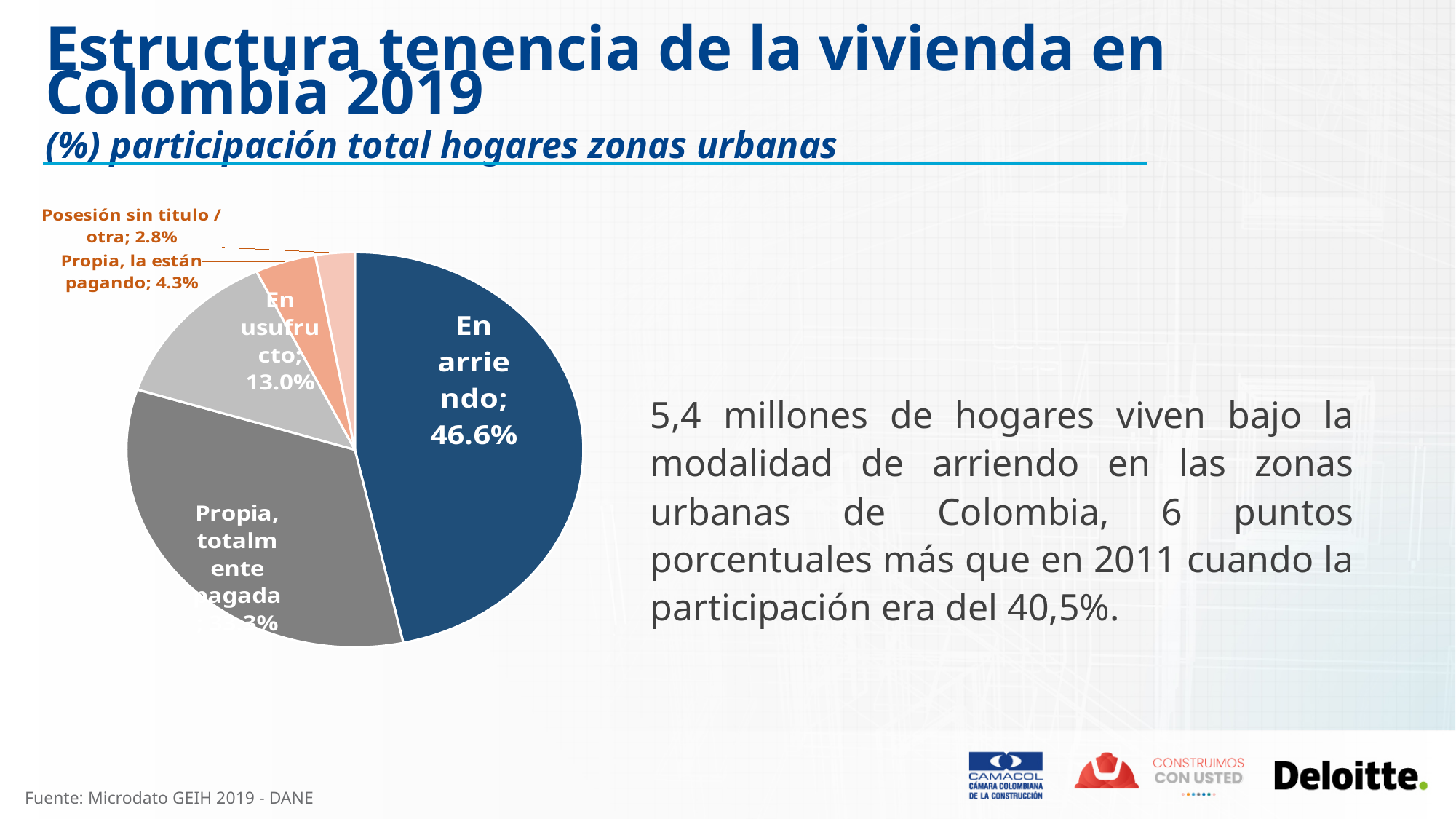
What percentage is labelled for 'Posesión sin titulo / otra'? 2.8% What percentage of urban households are 'En arriendo' according to the pie chart? 46.6% Which tenure category has the largest slice of the pie? En arriendo What is the value shown for 'Propia, la están pagando'? 4.3% By how many percentage points does 'En arriendo' exceed 'En usufructo'? 33.6 percentage points What type of chart is shown on the slide? Pie chart How many slices does the pie chart have? 5 What share does the 'En usufructo' slice show? 13.0% What colour is the 'En arriendo' slice? Dark blue Which tenure category has the smallest slice of the pie? Posesión sin titulo / otra What is the difference between 'En usufructo' and 'Propia, la están pagando'? 8.7 percentage points Which is larger, 'En usufructo' or 'Propia, la están pagando'? En usufructo